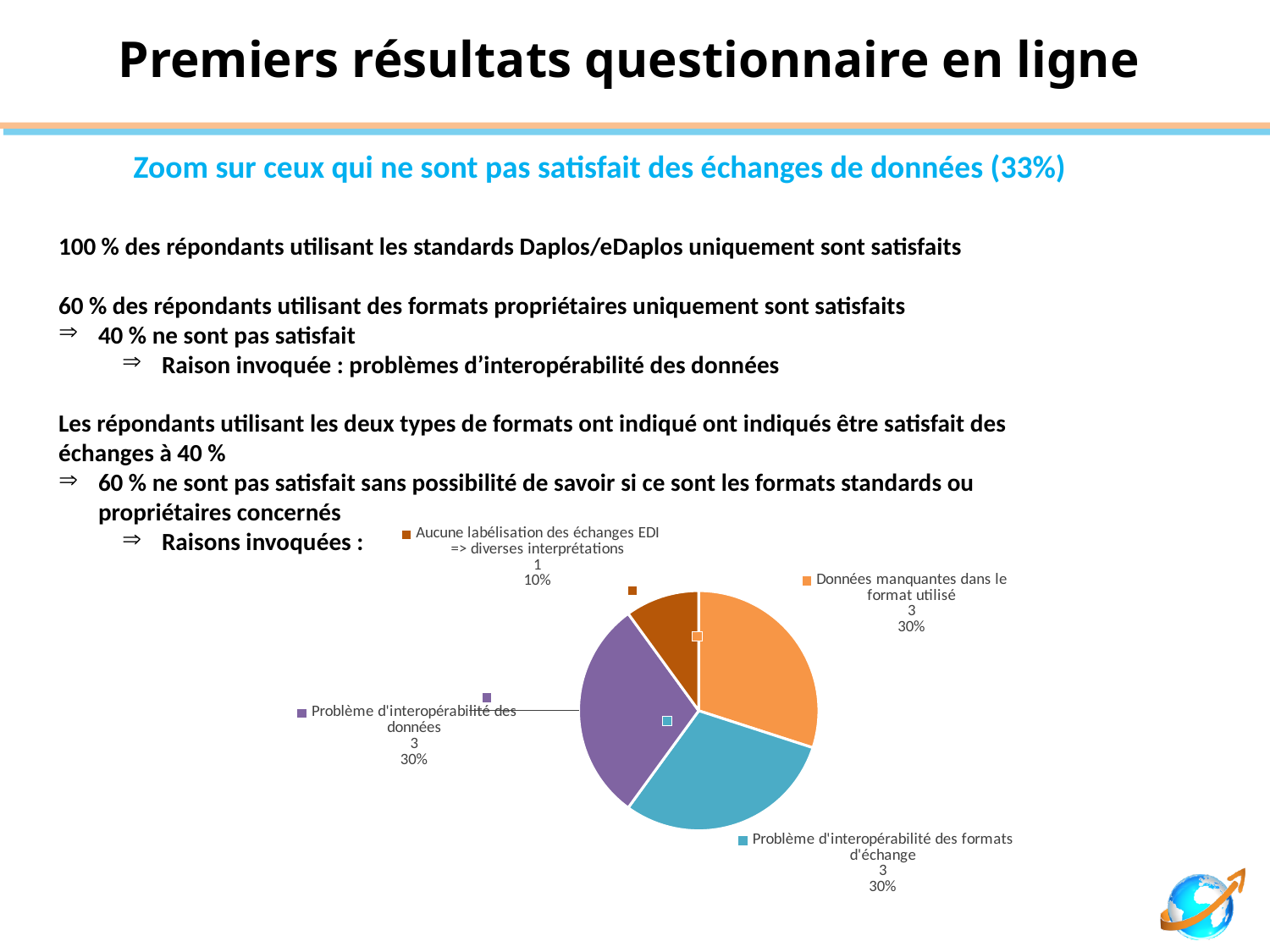
What colour is the slice for "Problème d'interopérabilité des données"? Purple What colour is the slice for "Données manquantes dans le format utilisé"? Orange Which slice of the pie chart has the smallest share? Aucune labélisation des échanges EDI => diverses interprétations How many slices does the pie chart have? 4 What count is shown for the slice "Données manquantes dans le format utilisé"? 3 What is the total of the counts shown across all slices of the pie chart? 10 What is the difference between the count for "Données manquantes dans le format utilisé" and the count for "Aucune labélisation des échanges EDI => diverses interprétations"? 2 What count is shown for the slice "Aucune labélisation des échanges EDI => diverses interprétations"? 1 What percentage is shown for the slice "Aucune labélisation des échanges EDI => diverses interprétations"? 10% What percentage is shown for the slice "Problème d'interopérabilité des formats d'échange"? 30% Which is larger: the count for "Problème d'interopérabilité des données" or the count for "Aucune labélisation des échanges EDI => diverses interprétations"? Problème d'interopérabilité des données What kind of chart is shown on the slide? Pie chart